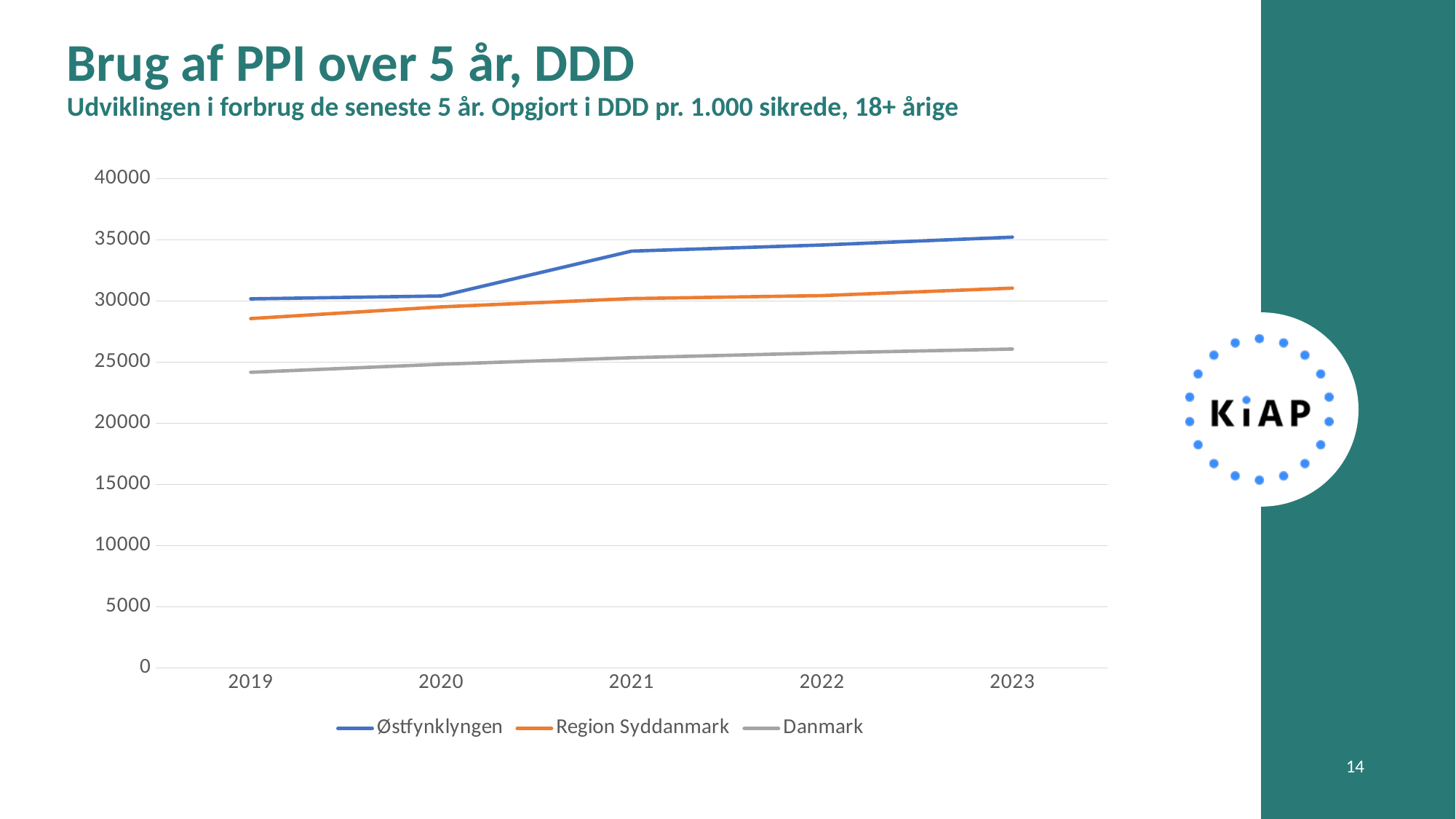
Which is larger in 2020, the value for Region Syddanmark or the value for Danmark? Region Syddanmark What kind of chart is shown on the slide? line chart Does the Danmark line rise or fall from 2019 to 2023? rise Is the value for Danmark in 2019 greater or less than 25000? less Which series is drawn in orange? Region Syddanmark How many series does the legend list? 3 Which series has the highest value in 2023? Østfynklyngen How many years are shown on the x axis? 5 Which series has the lowest value in 2019? Danmark Is the value for Østfynklyngen in 2021 greater or less than 30000? greater Is the value for Danmark in 2023 greater or less than 25000? greater